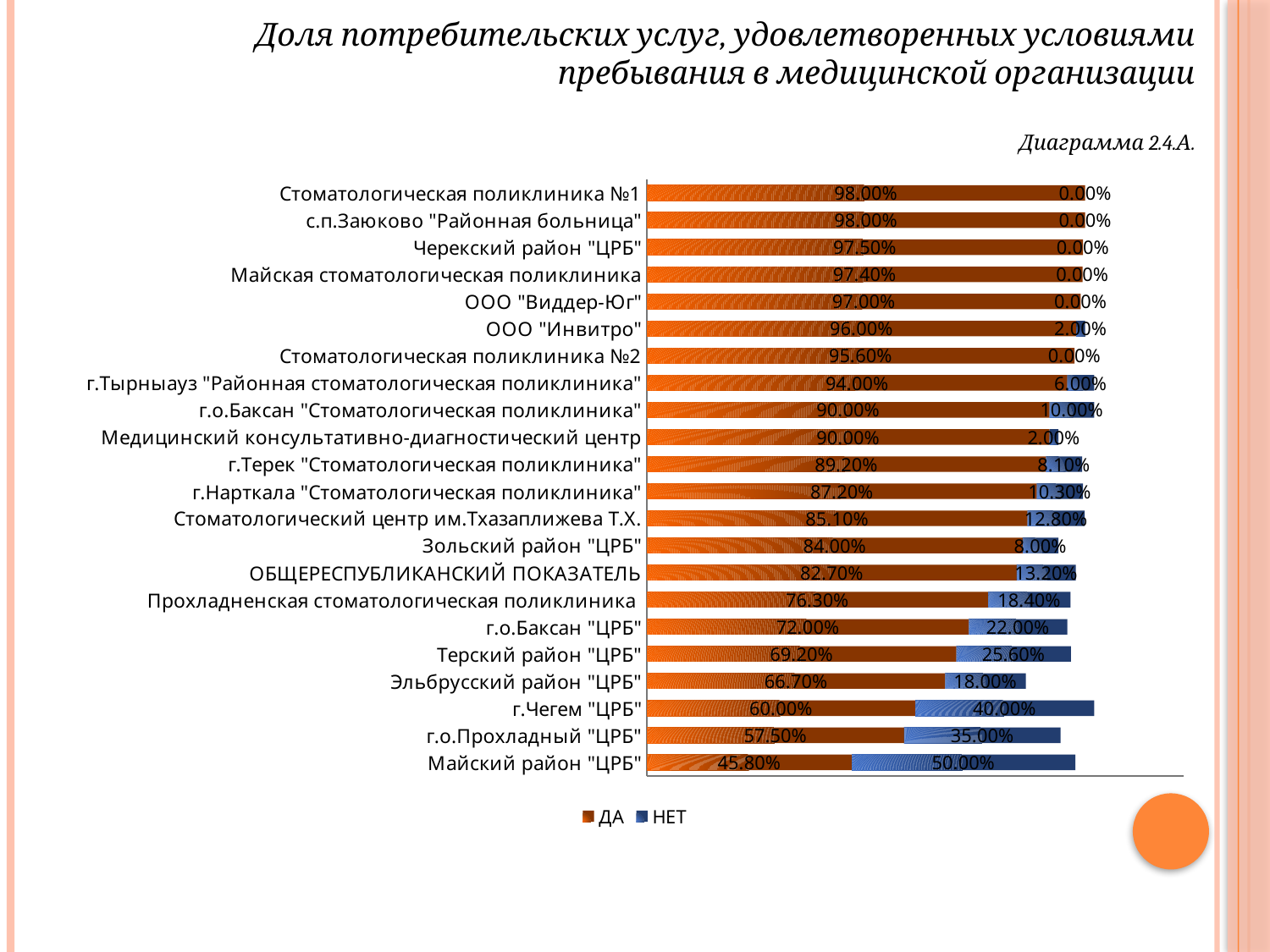
What are the two legend entries of the chart? ДА and НЕТ What is the НЕТ value for Стоматологический центр им.Тхазаплижева Т.Х.? 12.80% What is the total of the ДА and НЕТ values for Майский район "ЦРБ"? 95.80% Which has the larger НЕТ value: Терский район "ЦРБ" or г.о.Баксан "ЦРБ"? Терский район "ЦРБ" Which organisation has the lowest ДА value? Майский район "ЦРБ" How many organisations (categories) are plotted in the chart? 22 How many series does the legend list? 2 What is the ДА value for ОБЩЕРЕСПУБЛИКАНСКИЙ ПОКАЗАТЕЛЬ? 82.70% What is the ДА value for Прохладненская стоматологическая поликлиника? 76.30% What kind of chart is shown on the slide? Bar chart What is the difference between the ДА values for г.Чегем "ЦРБ" and г.о.Прохладный "ЦРБ"? 2.50% Which organisation has the highest НЕТ value? Майский район "ЦРБ"